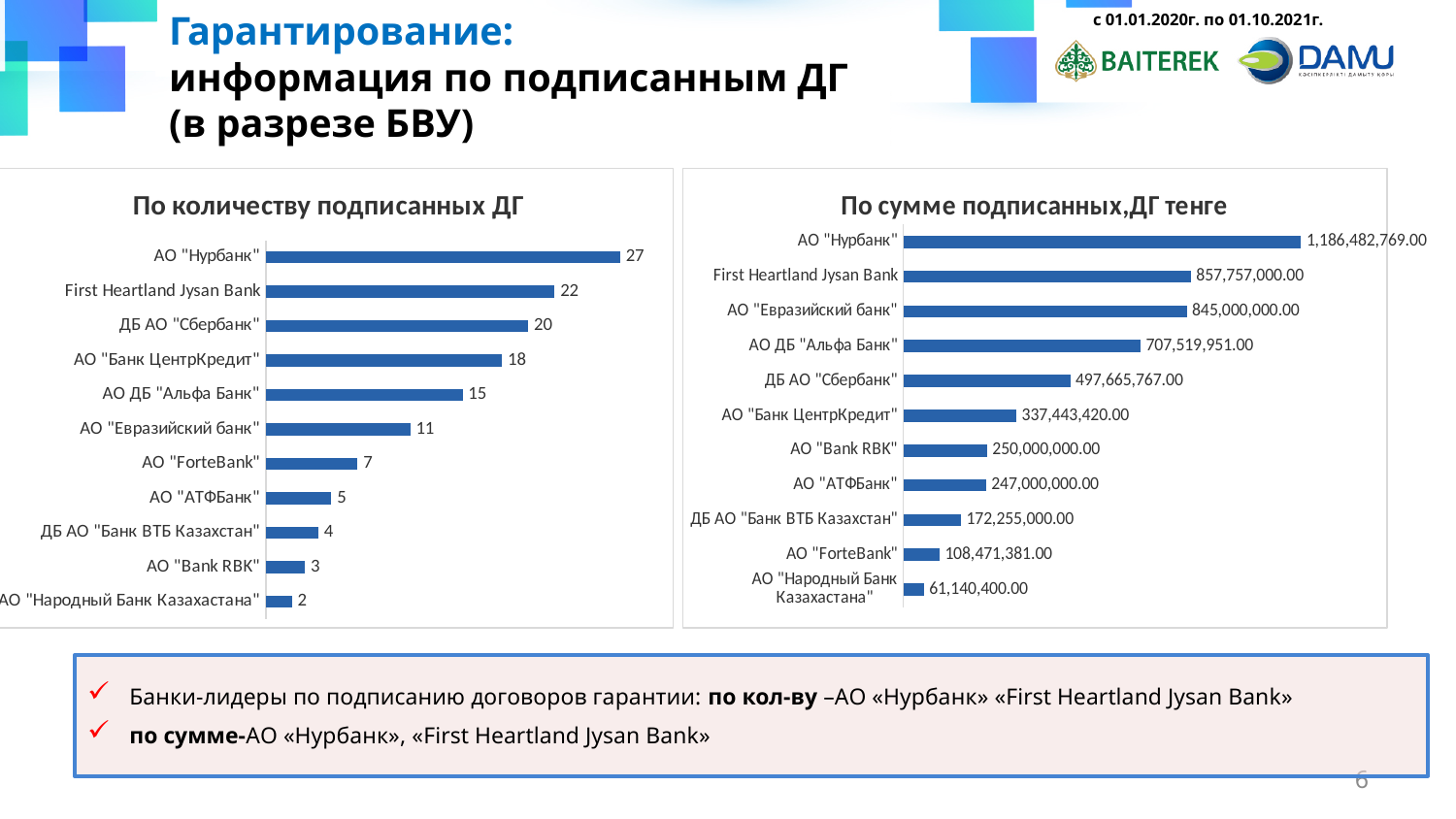
In the chart "По количеству подписанных ДГ", what is the value for АО "Нурбанк"? 27 What type of chart is "По сумме подписанных,ДГ тенге"? Bar chart In the chart "По количеству подписанных ДГ", what is the value for ДБ АО "Сбербанк"? 20 In the chart "По сумме подписанных,ДГ тенге", which bank has the highest value? АО "Нурбанк" In the chart "По количеству подписанных ДГ", how many banks are shown? 11 In the chart "По сумме подписанных,ДГ тенге", which is larger: АО "ForteBank" or ДБ АО "Банк ВТБ Казахстан"? ДБ АО "Банк ВТБ Казахстан" In the chart "По сумме подписанных,ДГ тенге", what is the value for АО "Евразийский банк"? 845,000,000.00 In the chart "По количеству подписанных ДГ", which is larger: АО "ForteBank" or АО "АТФБанк"? АО "ForteBank" In the chart "По сумме подписанных,ДГ тенге", what is the value for АО "Bank RBK"? 250,000,000.00 In the chart "По сумме подписанных,ДГ тенге", what is the difference between АО "Bank RBK" and АО "АТФБанк"? 3,000,000.00 In the chart "По количеству подписанных ДГ", what is the difference between АО "Нурбанк" and First Heartland Jysan Bank? 5 In the chart "По количеству подписанных ДГ", which bank has the lowest value? АО "Народный Банк Казахастана"